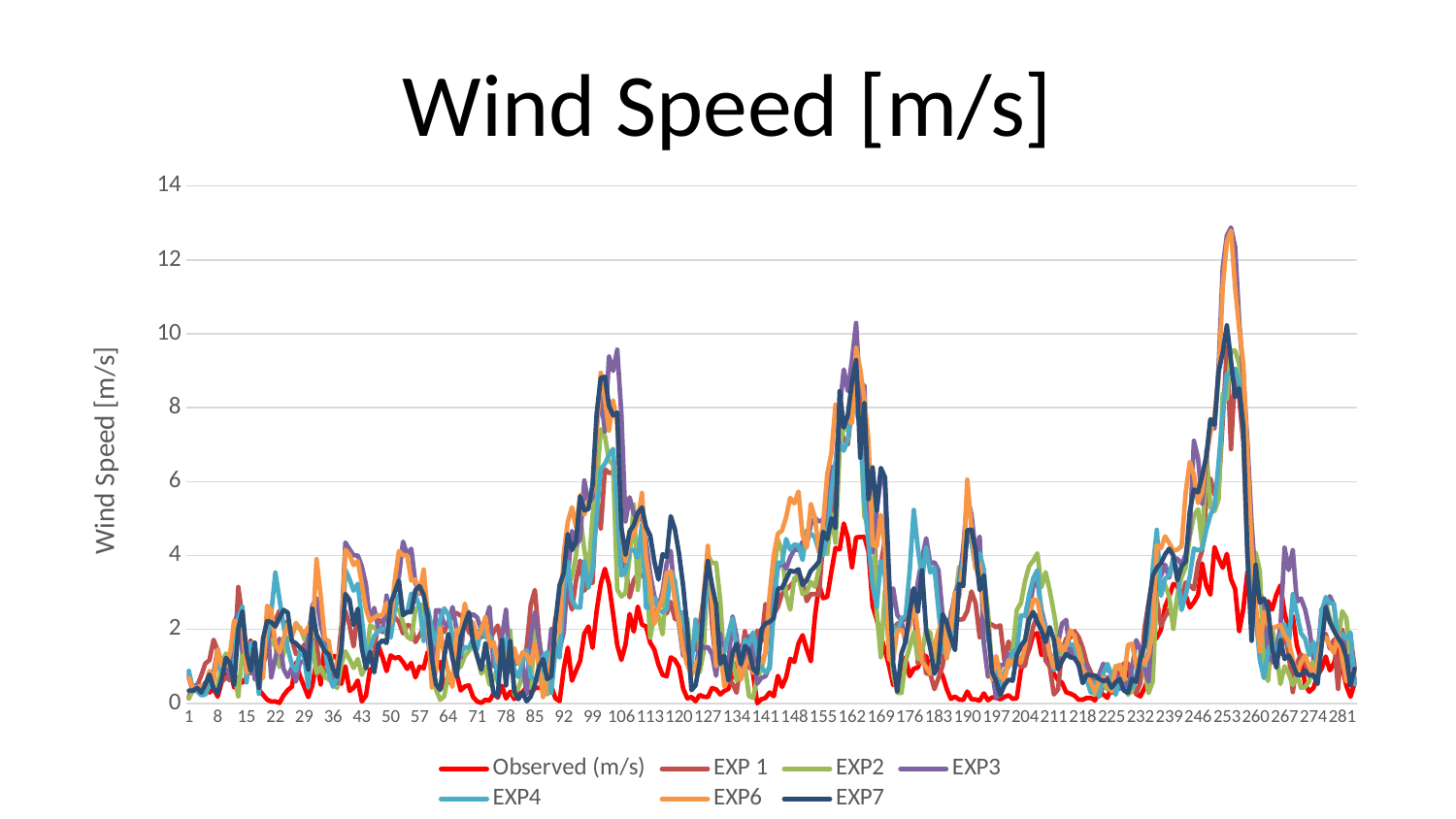
Which series has the lowest value at the peak around x = 253? Observed (m/s) Around x = 253, is the Observed (m/s) series higher or lower than EXP7? lower Is the peak value of EXP6 near x = 253 greater or less than 12? greater Is the value of EXP7 at its peak near x = 253 greater or less than 8? greater What is the title of the chart? Wind Speed [m/s] What is the label on the vertical axis? Wind Speed [m/s] What is the last tick label shown on the horizontal axis? 281 What kind of chart is shown on the slide? line chart What is the highest value shown on the vertical axis? 14 Is the Observed (m/s) value at x = 1 greater or less than 2? less How many series does the legend list? 7